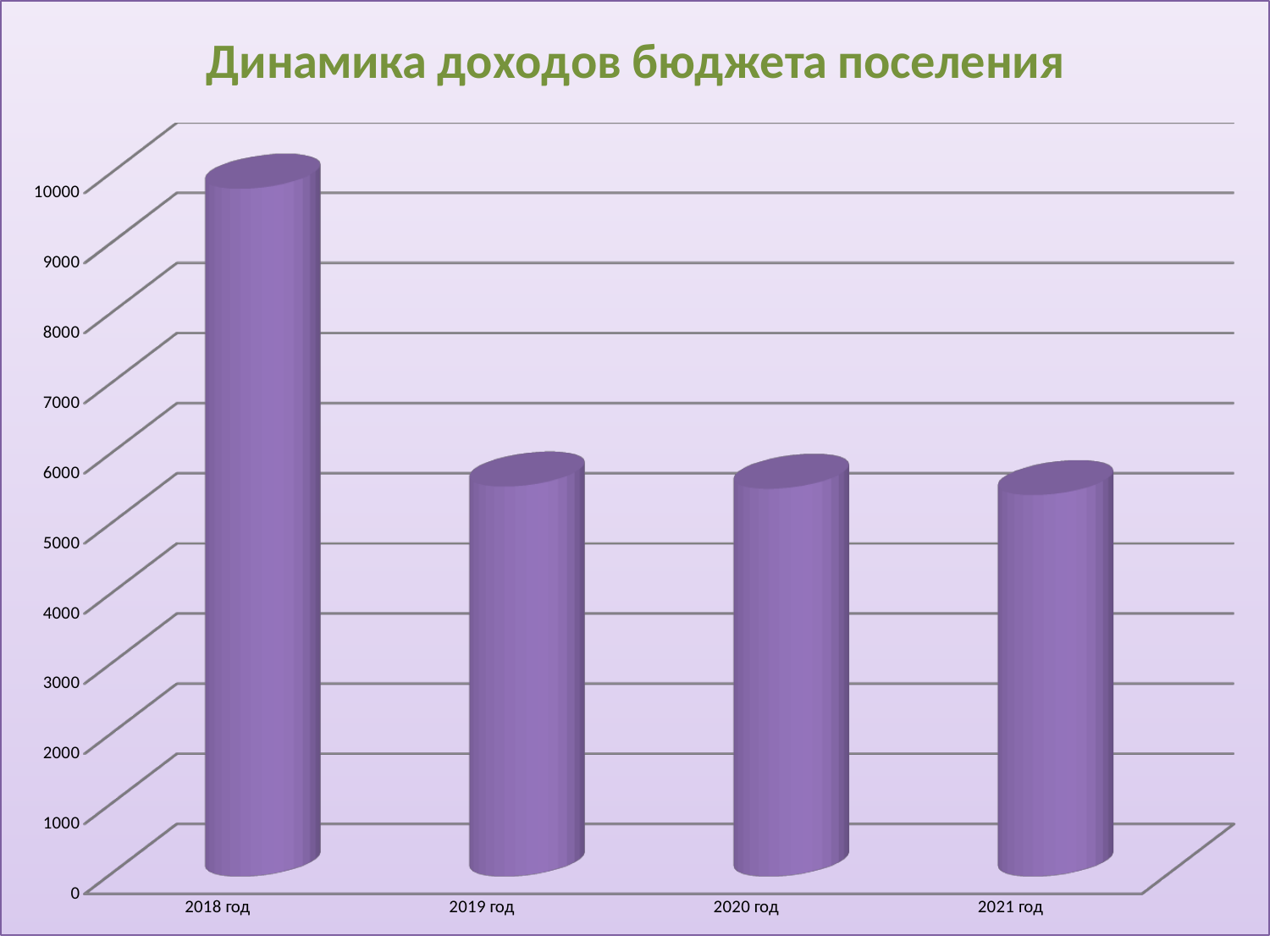
Is the value for 2019 год greater or less than 5000? greater Is the value for 2018 год greater or less than 9000? greater Which is larger, the value for 2018 год or the value for 2021 год? 2018 год How many categories (years) are shown on the x axis? 4 Is the value for 2020 год greater or less than 7000? less Do the values rise or fall from 2018 год to 2019 год? fall What colour are the bars in the chart? Purple Which is larger, the value for 2018 год or the value for 2019 год? 2018 год What is the title of the chart? Динамика доходов бюджета поселения Which year has the highest value? 2018 год What kind of chart is shown on the slide? Bar chart